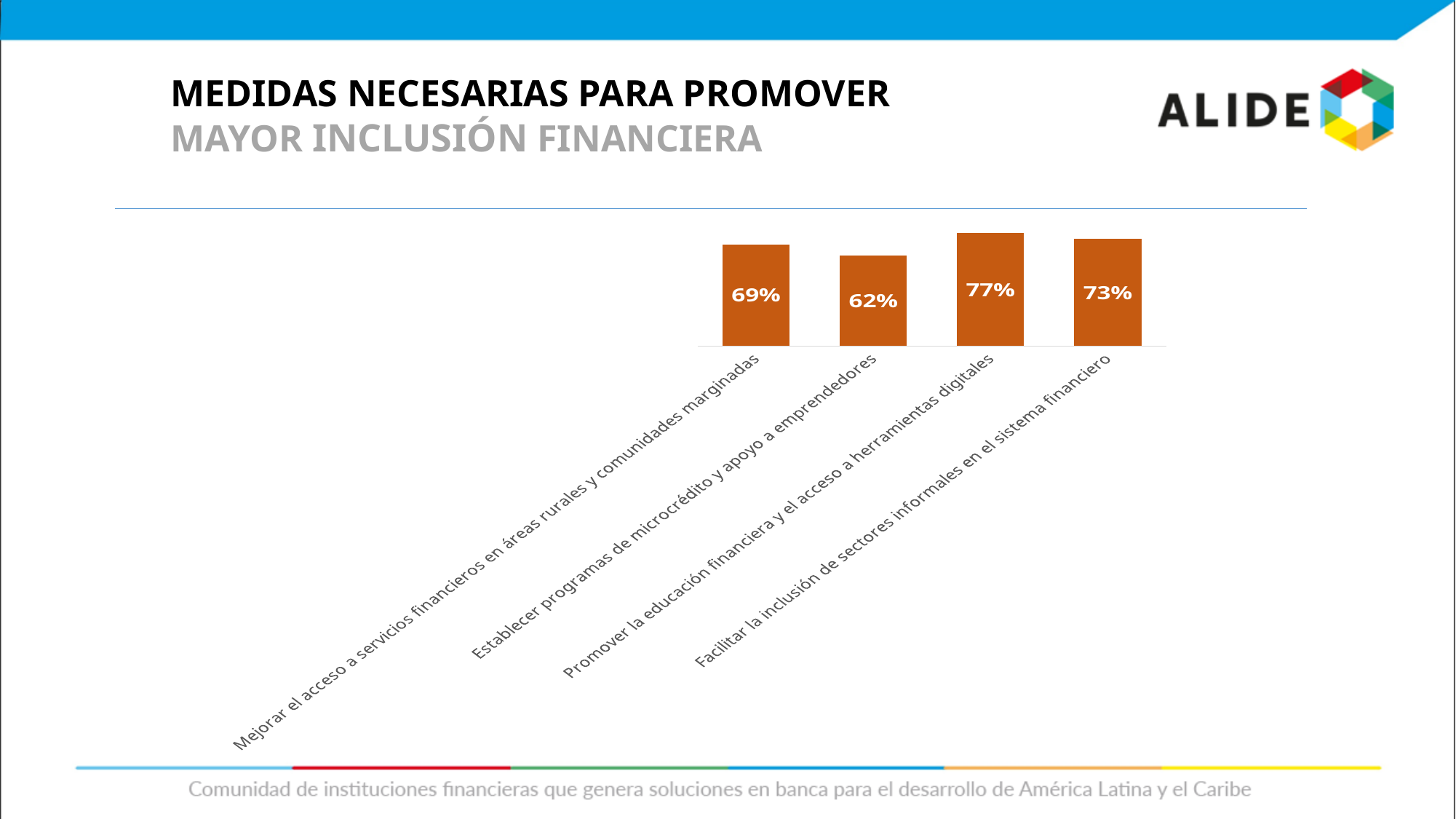
Which measure has the highest value? Promover la educación financiera y el acceso a herramientas digitales What colour are the bars in the chart? Orange What is the difference between the highest and lowest values shown? 15% What is the value for 'Establecer programas de microcrédito y apoyo a emprendedores'? 62% Which is larger: the value for 'Facilitar la inclusión de sectores informales en el sistema financiero' or for 'Establecer programas de microcrédito y apoyo a emprendedores'? Facilitar la inclusión de sectores informales en el sistema financiero What kind of chart is shown on the slide? Bar chart Which measure has the lowest value? Establecer programas de microcrédito y apoyo a emprendedores What is the difference between 'Facilitar la inclusión de sectores informales en el sistema financiero' and 'Mejorar el acceso a servicios financieros en áreas rurales y comunidades marginadas'? 4% What is the value for 'Promover la educación financiera y el acceso a herramientas digitales'? 77% How many measures (categories) are shown in the chart? 4 What is the value for 'Facilitar la inclusión de sectores informales en el sistema financiero'? 73% What is the value for 'Mejorar el acceso a servicios financieros en áreas rurales y comunidades marginadas'? 69%